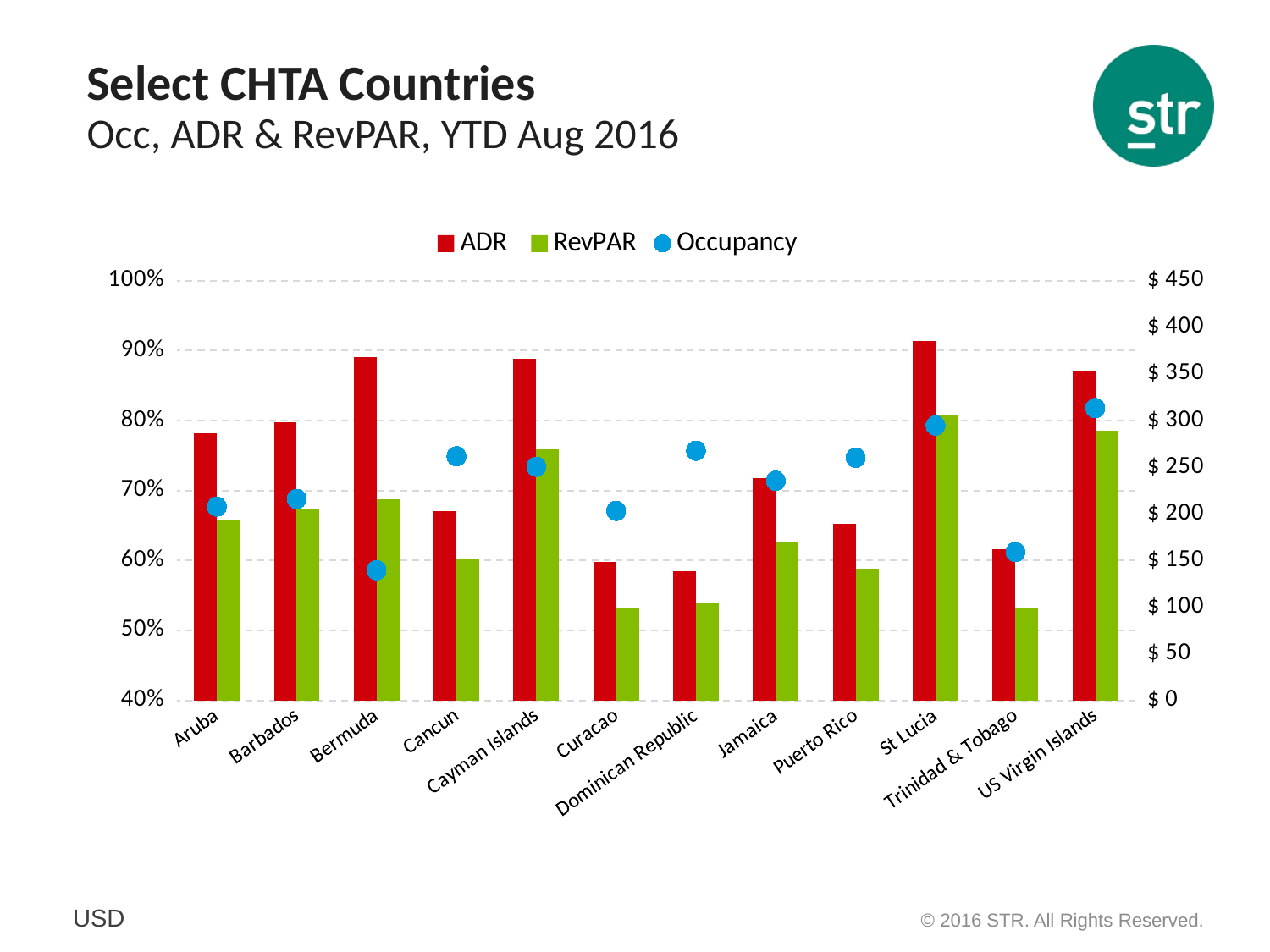
How many countries are shown on the x axis of the chart? 12 Is the Occupancy value for Bermuda greater or less than 70%? less Is the ADR value for Cancun greater or less than $250? less Which has the larger RevPAR, Jamaica or Puerto Rico? Jamaica Which has the larger ADR, Cayman Islands or Cancun? Cayman Islands Which country has the highest Occupancy? US Virgin Islands Which country has the highest RevPAR? St Lucia Is the RevPAR value for Curacao greater or less than $150? less Which country has the highest ADR? St Lucia How many series does the chart legend list? 3 Which series are listed in the chart legend? ADR, RevPAR, Occupancy